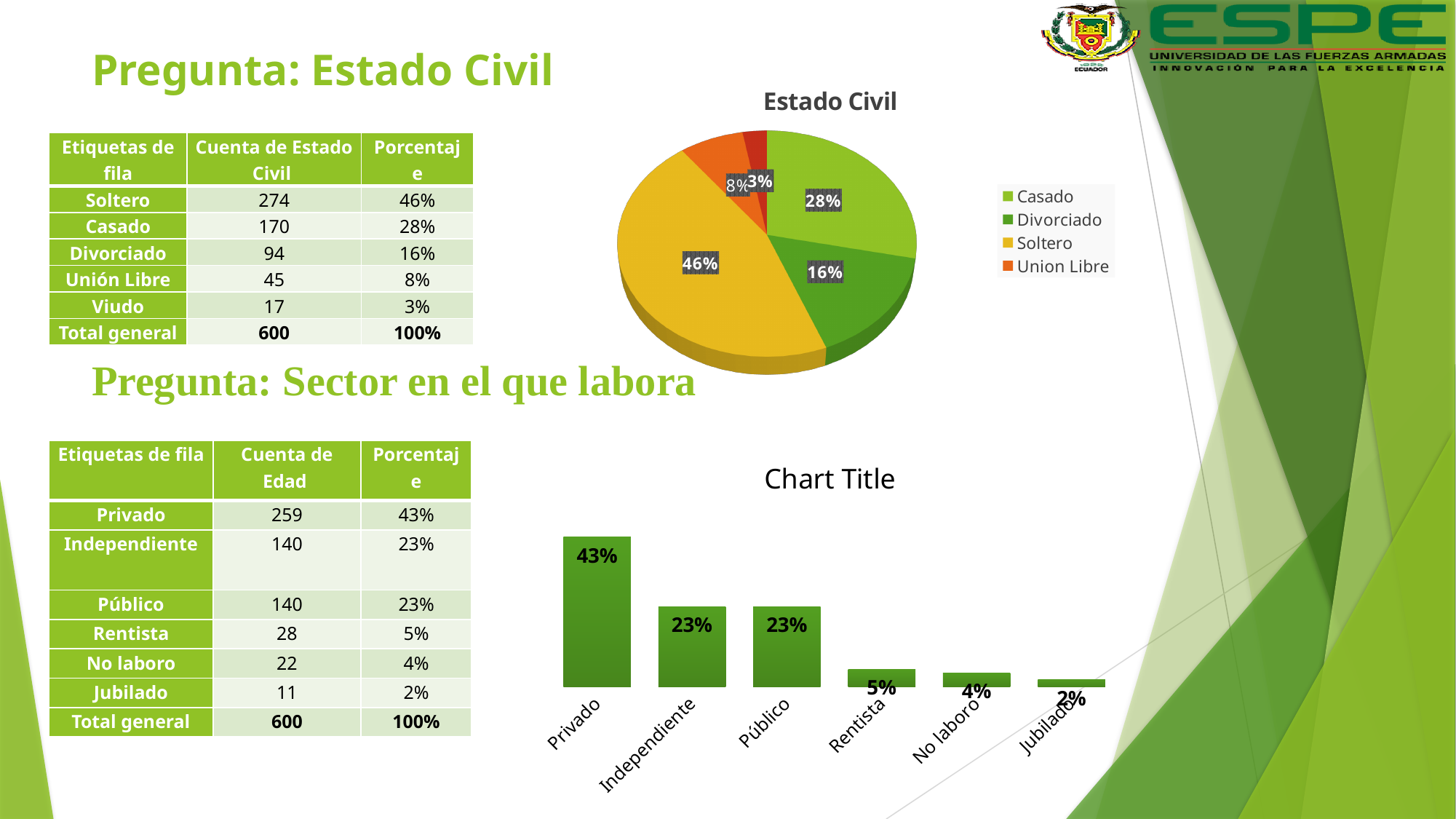
What kind of chart is the "Estado Civil" chart? Pie chart In the "Chart Title" bar chart, what is the value for Privado? 43% In the "Chart Title" bar chart, how many categories are shown on the x axis? 6 In the "Estado Civil" pie chart, what share does Casado have? 28% In the "Chart Title" bar chart, which category has the lowest value? Jubilado In the "Estado Civil" pie chart, what share does Divorciado have? 16% In the "Chart Title" bar chart, which is larger, No laboro or Jubilado? No laboro In the "Chart Title" bar chart, what is the difference between Privado and Independiente? 20% In the "Chart Title" bar chart, what is the value for Rentista? 5% In the "Estado Civil" pie chart, how many entries does the legend list? 4 In the "Estado Civil" pie chart, which category has the largest slice? Soltero In the "Estado Civil" pie chart, what share does Soltero have? 46%